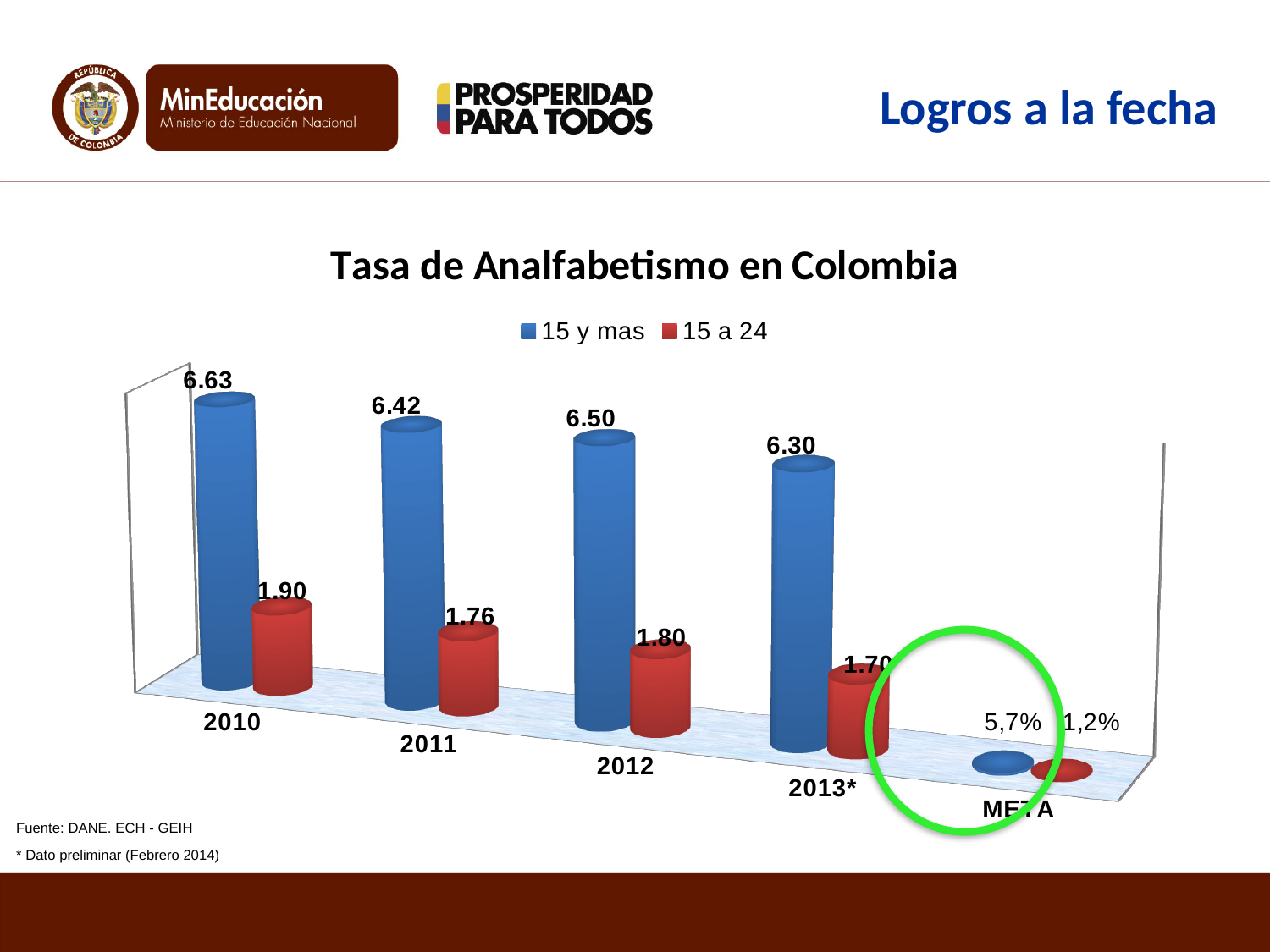
In which year is the '15 y mas' value highest? 2010 How many series does the legend list? 2 How many categories are shown on the x axis? 5 Among the years 2010 to 2013*, in which year is the '15 y mas' value lowest? 2013* Which year has the larger '15 a 24' value, 2010 or 2012? 2010 What is the META value shown for '15 y mas'? 5,7% What is the value for '15 a 24' in 2011? 1.76 What is the value for '15 y mas' in 2013*? 6.30 What is the difference between the '15 y mas' values for 2010 and 2011? 0.21 What is the value for '15 y mas' in 2010? 6.63 What kind of chart is this? bar chart What is the title of the chart? Tasa de Analfabetismo en Colombia